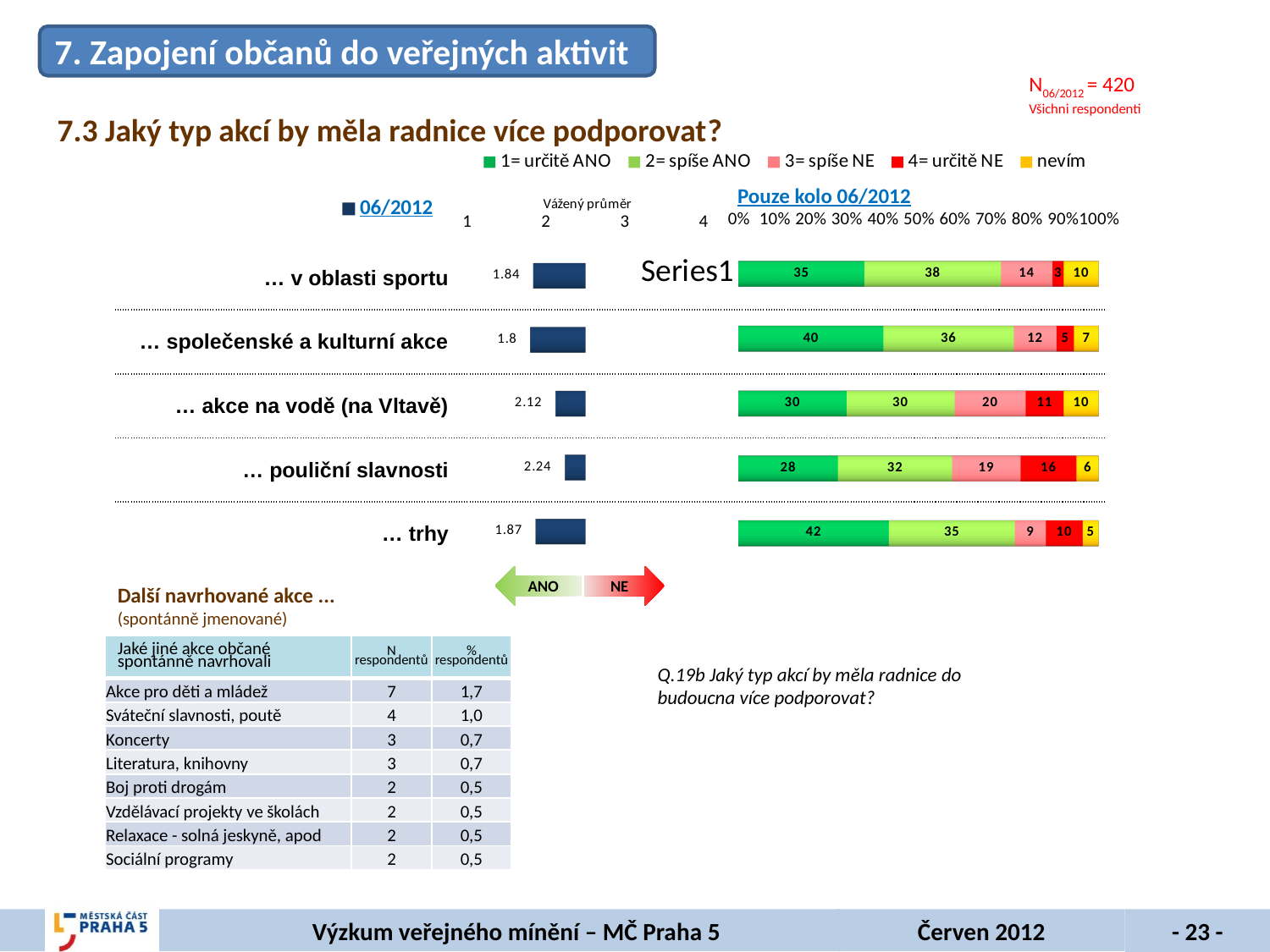
How many series does the legend of the stacked bar chart 'Pouze kolo 06/2012' list? 5 In the weighted average (Vážený průměr) chart, what is the difference between the values for '… pouliční slavnosti' and '… akce na vodě (na Vltavě)'? 0.12 In the weighted average (Vážený průměr) chart, what is the value for '… pouliční slavnosti'? 2.24 In the weighted average (Vážený průměr) chart, which category has the highest value? … pouliční slavnosti In the weighted average (Vážený průměr) chart, which category has the lowest value? … společenské a kulturní akce In the stacked bar chart 'Pouze kolo 06/2012', which has the larger '1= určitě ANO' value: '… v oblasti sportu' or '… společenské a kulturní akce'? … společenské a kulturní akce How many categories are shown in the stacked bar chart 'Pouze kolo 06/2012'? 5 In the stacked bar chart 'Pouze kolo 06/2012', what is the '1= určitě ANO' value for '… trhy'? 42 In the stacked bar chart 'Pouze kolo 06/2012', which category has the highest '3= spíše NE' value? … akce na vodě (na Vltavě) In the stacked bar chart 'Pouze kolo 06/2012', what is the '4= určitě NE' value for '… pouliční slavnosti'? 16 In the stacked bar chart 'Pouze kolo 06/2012', what is the total of the segments for '… v oblasti sportu'? 100 What kind of chart is the 'Pouze kolo 06/2012' chart? Stacked bar chart